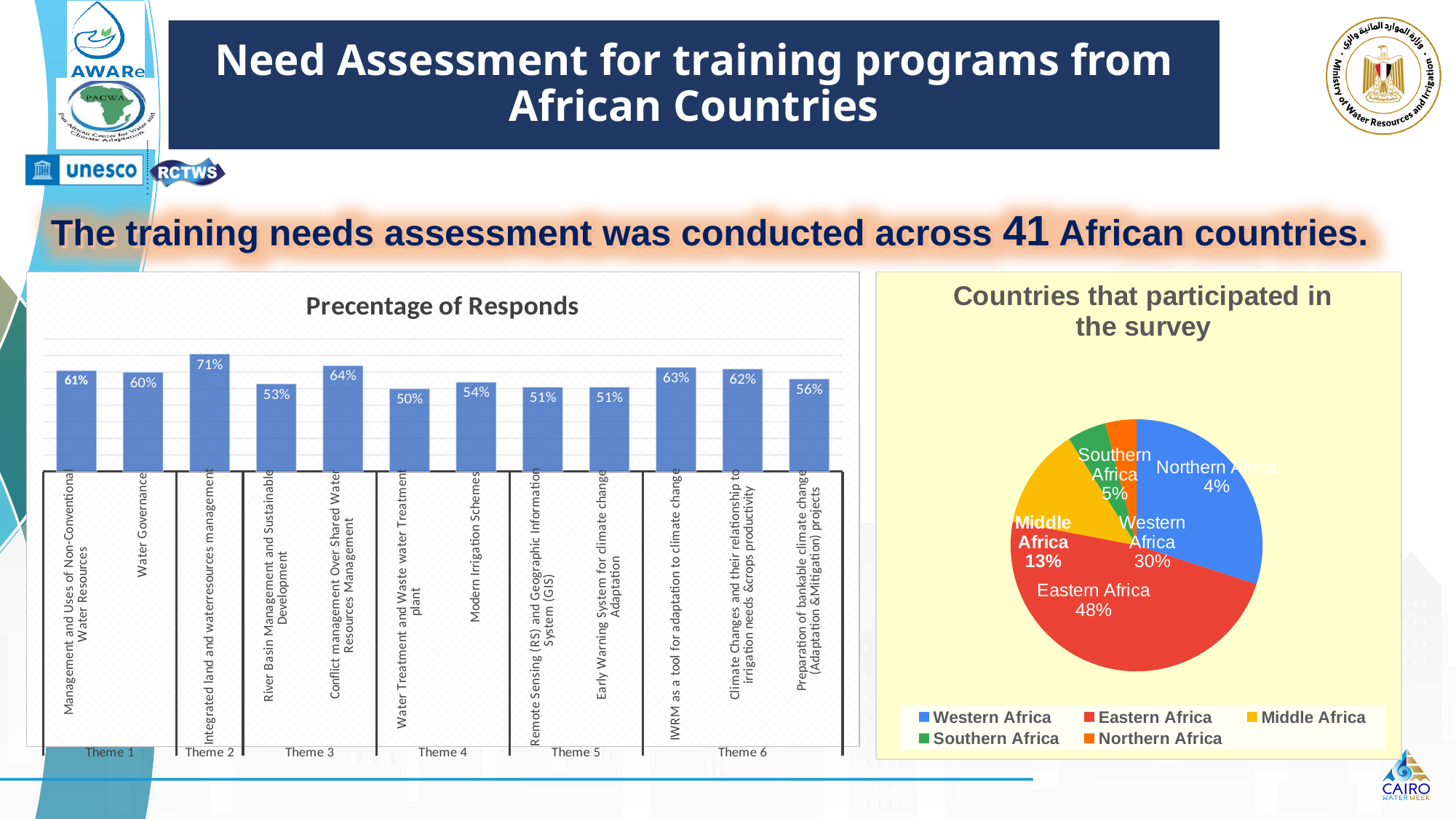
In the 'Precentage of Responds' bar chart, which category has the lowest value? Water Treatment and Waste water Treatment plant In the 'Precentage of Responds' bar chart, what is the difference between the values for Integrated land and waterresources management and Water Governance? 11% How many bars are plotted in the 'Precentage of Responds' chart? 12 In the 'Precentage of Responds' bar chart, what is the value for Modern Irrigation Schemes? 54% In the 'Precentage of Responds' bar chart, which is larger: the value for Conflict management Over Shared Water Resources Management or the value for River Basin Management and Sustainable Development? Conflict management Over Shared Water Resources Management How many regions does the legend of the 'Countries that participated in the survey' pie chart list? 5 In the 'Countries that participated in the survey' pie chart, what share does Eastern Africa have? 48% In the 'Countries that participated in the survey' pie chart, which region has the smallest share? Northern Africa In the 'Precentage of Responds' bar chart, which category has the highest value? Integrated land and waterresources management In the 'Countries that participated in the survey' pie chart, what is the difference between the shares of Western Africa and Middle Africa? 17% What kind of chart is 'Precentage of Responds'? Bar chart In the 'Precentage of Responds' bar chart, what is the value for Water Governance? 60%